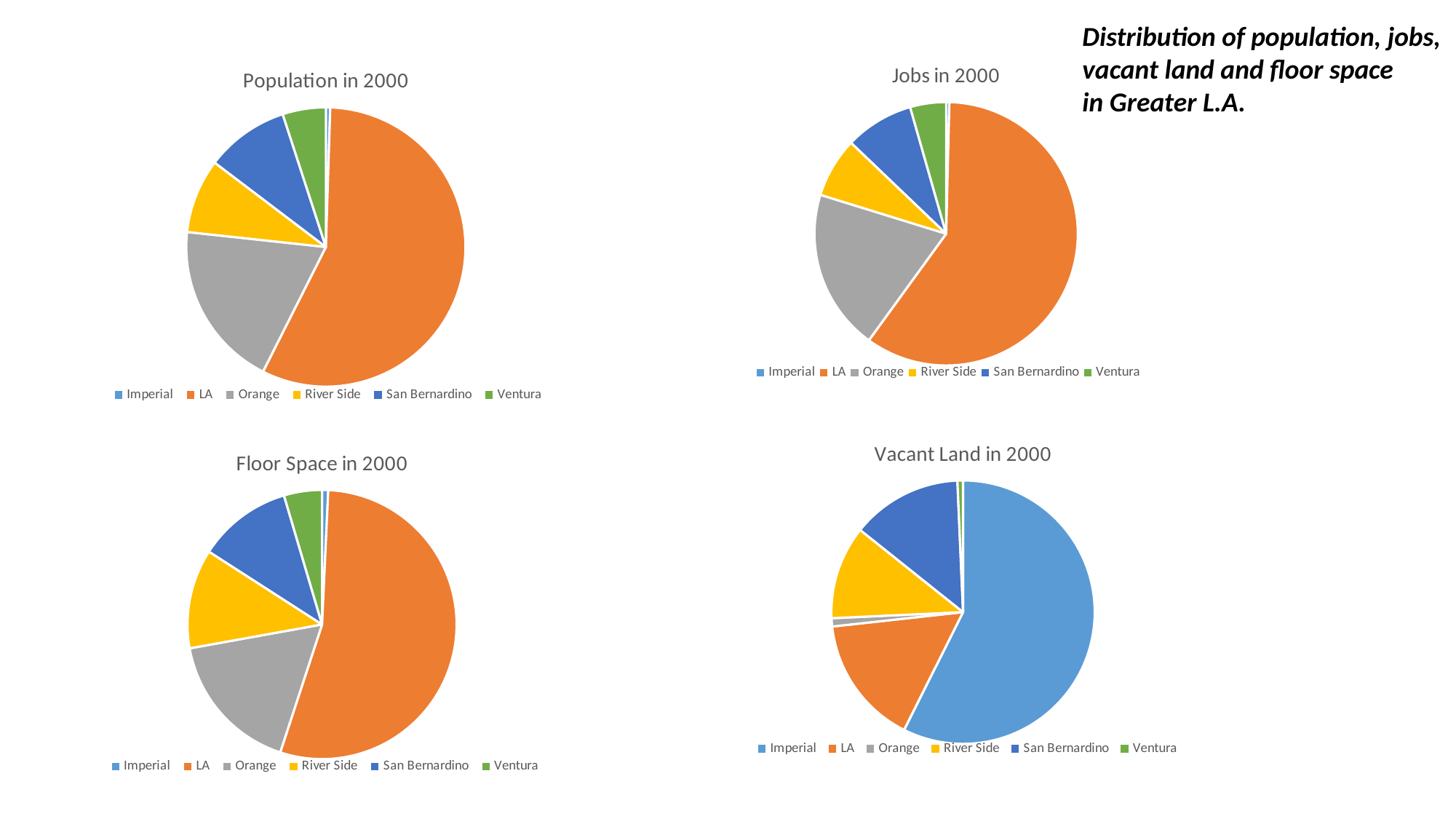
In the "Vacant Land in 2000" chart, which slice is larger, LA or San Bernardino? LA What kind of chart is the "Population in 2000" chart? Pie chart In the "Floor Space in 2000" chart, which county has the smallest slice? Imperial How many pie charts are shown on the slide? 4 In the "Jobs in 2000" chart, which county has the largest slice? LA In the "Population in 2000" chart, which slice is larger, Orange or River Side? Orange In the "Vacant Land in 2000" chart, which county has the largest slice? Imperial In the "Population in 2000" chart, which county has the smallest slice? Imperial In the "Jobs in 2000" chart, which slice is larger, Orange or San Bernardino? Orange How many categories does the legend of the "Jobs in 2000" chart list? 6 In the "Population in 2000" chart, which county has the largest slice? LA What is the title of the chart in the bottom-right of the slide? Vacant Land in 2000